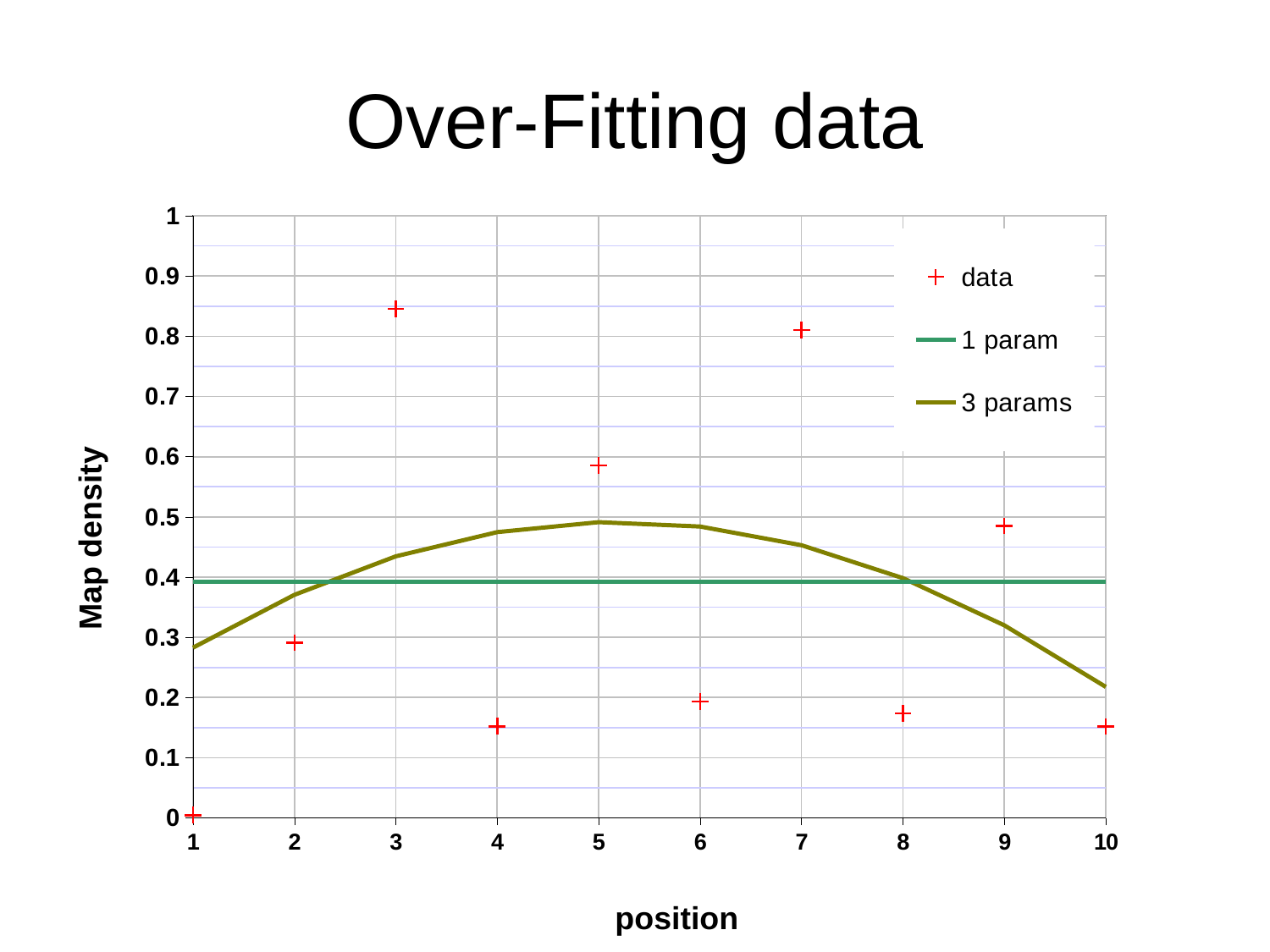
What is the label of the y axis? Map density Is the data value at position 4 greater or less than 0.2? less Is the 1 param line greater or less than 0.3? greater How many data points (red crosses) are plotted? 10 At which position is the data value lowest? 1 Is the data value at position 7 greater or less than 0.7? greater Which has the larger data value, position 5 or position 6? position 5 How many entries does the legend list? 3 What is the title of the chart? Over-Fitting data Which has the larger data value, position 3 or position 4? position 3